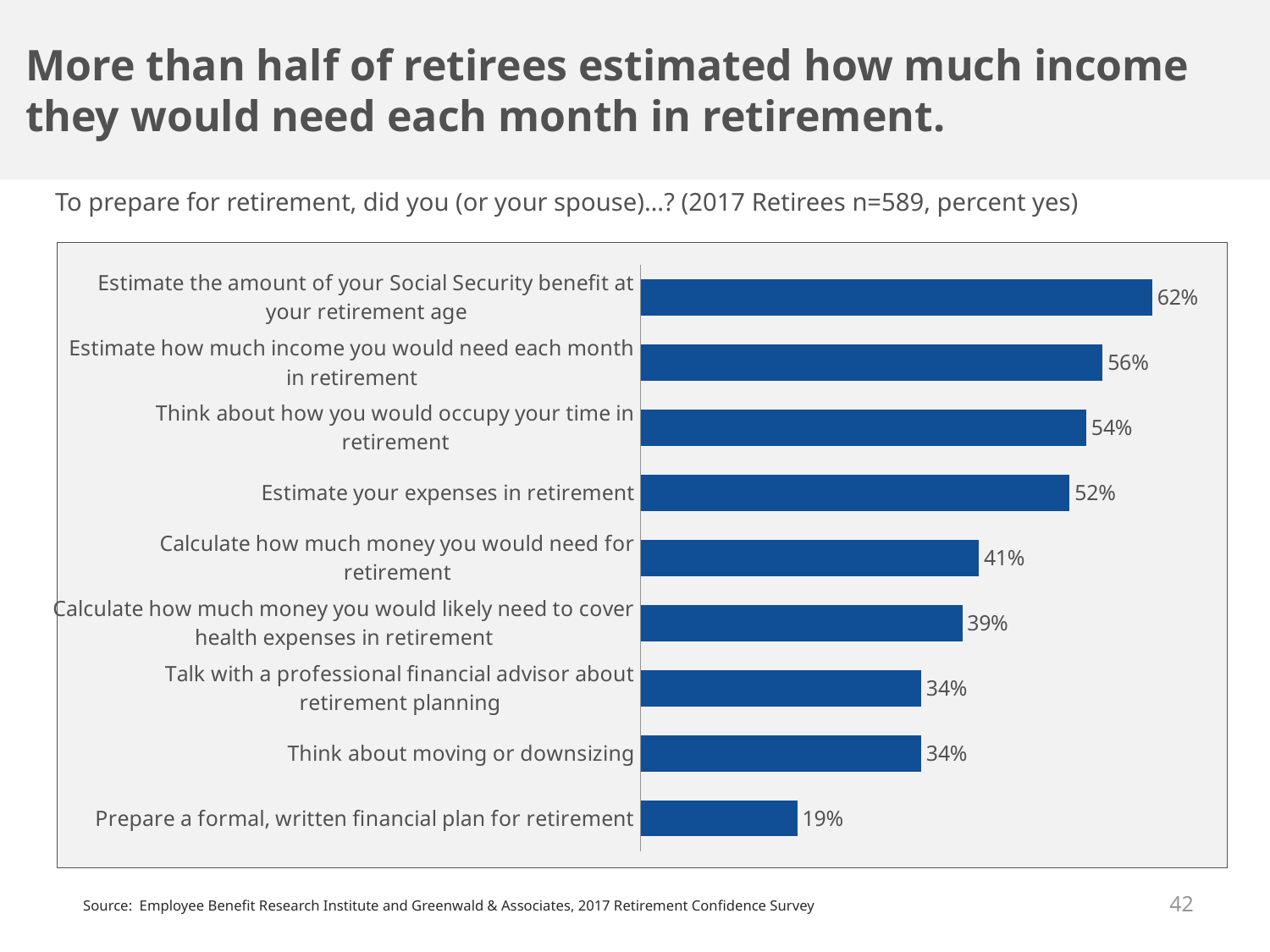
How many categories are shown in the chart? 9 What percentage of retirees said they prepared a formal, written financial plan for retirement? 19% What is the difference between the highest and lowest values in the chart? 43% Which is larger: the value for 'Think about how you would occupy your time in retirement' or the value for 'Calculate how much money you would need for retirement'? Think about how you would occupy your time in retirement What kind of chart is shown on the slide? Bar chart Which two categories share the same value of 34%? Talk with a professional financial advisor about retirement planning; Think about moving or downsizing Which category has the lowest value in the chart? Prepare a formal, written financial plan for retirement What is the sample size of retirees stated in the chart's subtitle? n=589 Which category has the highest value in the chart? Estimate the amount of your Social Security benefit at your retirement age What is the value for 'Calculate how much money you would likely need to cover health expenses in retirement'? 39% What percentage of retirees said they estimated the amount of their Social Security benefit at their retirement age? 62% What is the difference between the value for 'Estimate how much income you would need each month in retirement' and the value for 'Estimate your expenses in retirement'? 4%